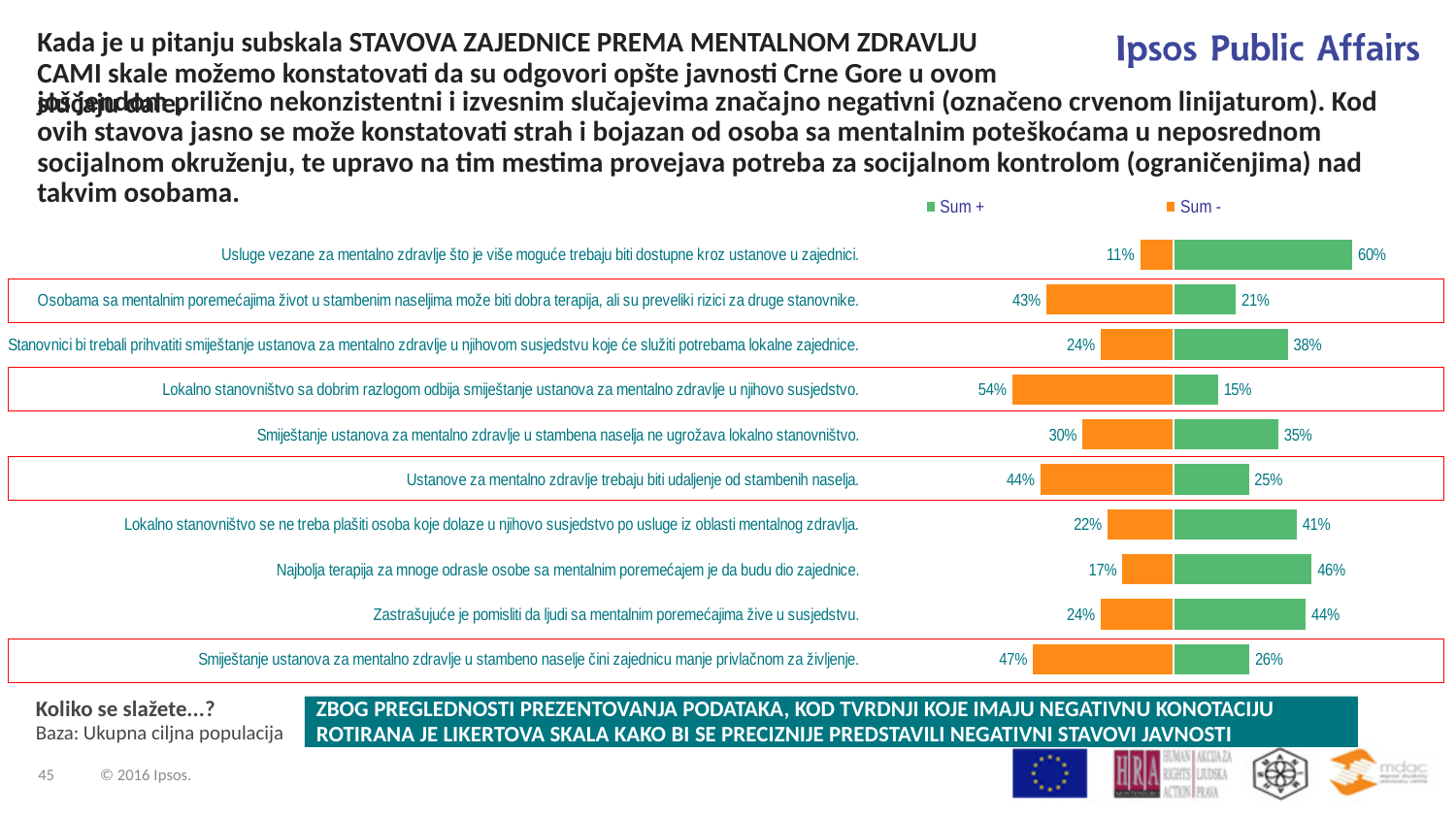
Which statement has the lowest Sum + value? Lokalno stanovništvo sa dobrim razlogom odbija smiještanje ustanova za mentalno zdravlje u njihovo susjedstvo. Which statement has the highest Sum + value? Usluge vezane za mentalno zdravlje što je više moguće trebaju biti dostupne kroz ustanove u zajednici. What type of chart is shown on the slide? bar chart What is the Sum + value for the statement "Najbolja terapija za mnoge odrasle osobe sa mentalnim poremećajem je da budu dio zajednice"? 46% How many series does the chart legend list? 2 What is the difference between the Sum - and Sum + values for the statement "Ustanove za mentalno zdravlje trebaju biti udaljenje od stambenih naselja"? 19% Which colour represents the Sum - series in the chart? orange For the statement "Smiještanje ustanova za mentalno zdravlje u stambena naselja ne ugrožava lokalno stanovništvo", which is larger, Sum + or Sum -? Sum + What is the Sum + value for the statement "Usluge vezane za mentalno zdravlje što je više moguće trebaju biti dostupne kroz ustanove u zajednici"? 60% Which statement has the lowest Sum - value? Usluge vezane za mentalno zdravlje što je više moguće trebaju biti dostupne kroz ustanove u zajednici. How many statements (categories) are plotted in the chart? 10 What is the Sum - value for the statement "Lokalno stanovništvo sa dobrim razlogom odbija smiještanje ustanova za mentalno zdravlje u njihovo susjedstvo"? 54%